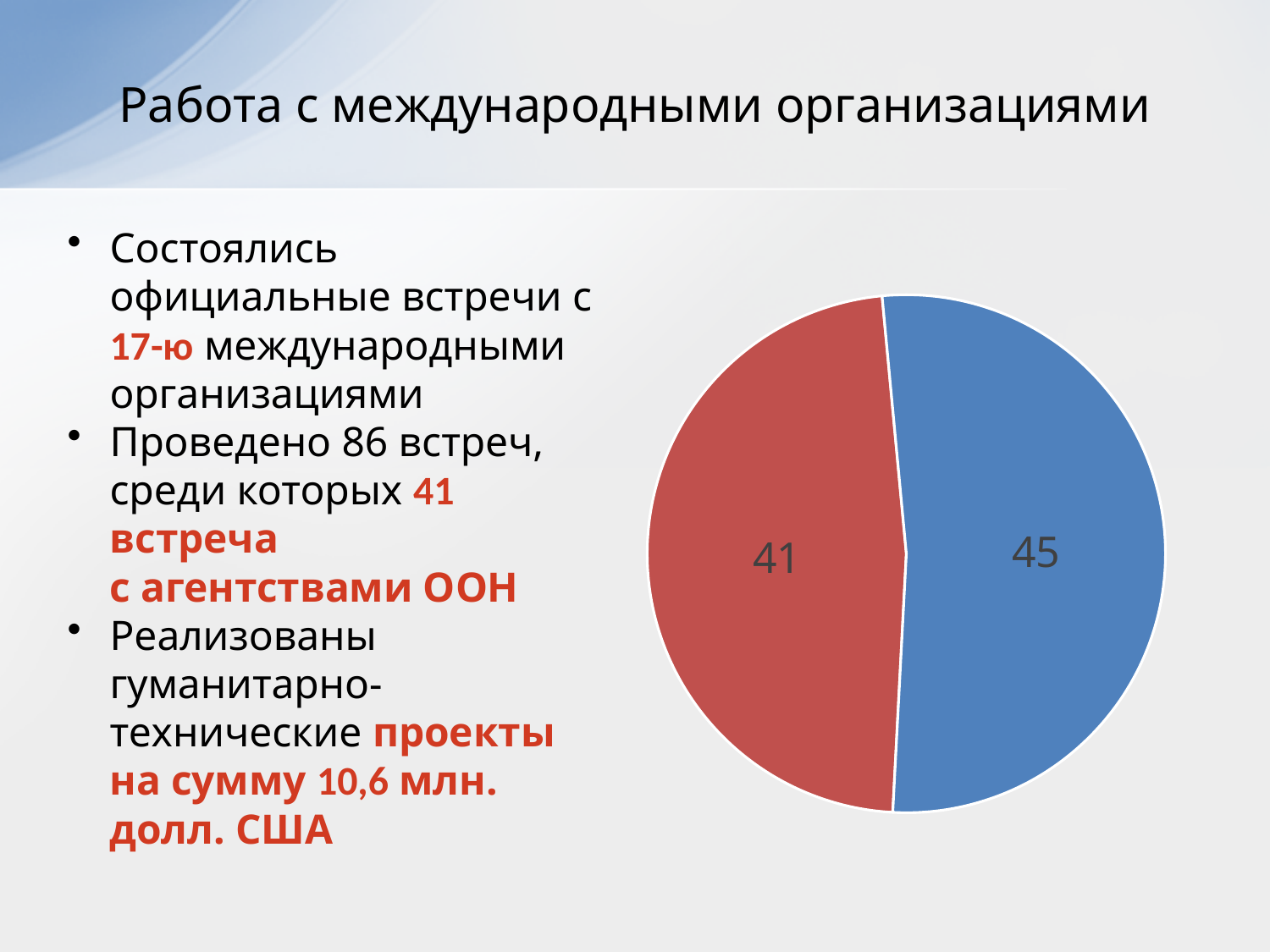
Which slice of the pie chart has the larger value, the blue one or the red one? the blue one Is the value of the red slice larger or smaller than the value of the blue slice? smaller What value is shown on the blue slice of the pie chart? 45 How many slices does the pie chart have? 2 Which slice of the pie chart has the smaller value? the red slice What value is shown on the red slice of the pie chart? 41 What is the difference between the values of the blue slice and the red slice in the pie chart? 4 What is the total of the two values shown in the pie chart? 86 What type of chart is shown on the slide? pie chart What share of the pie chart does the blue slice (45) represent, as a percentage of the total 86? 52.3% What is the title of the slide containing the pie chart? Работа с международными организациями What colours are the two slices of the pie chart? blue and red